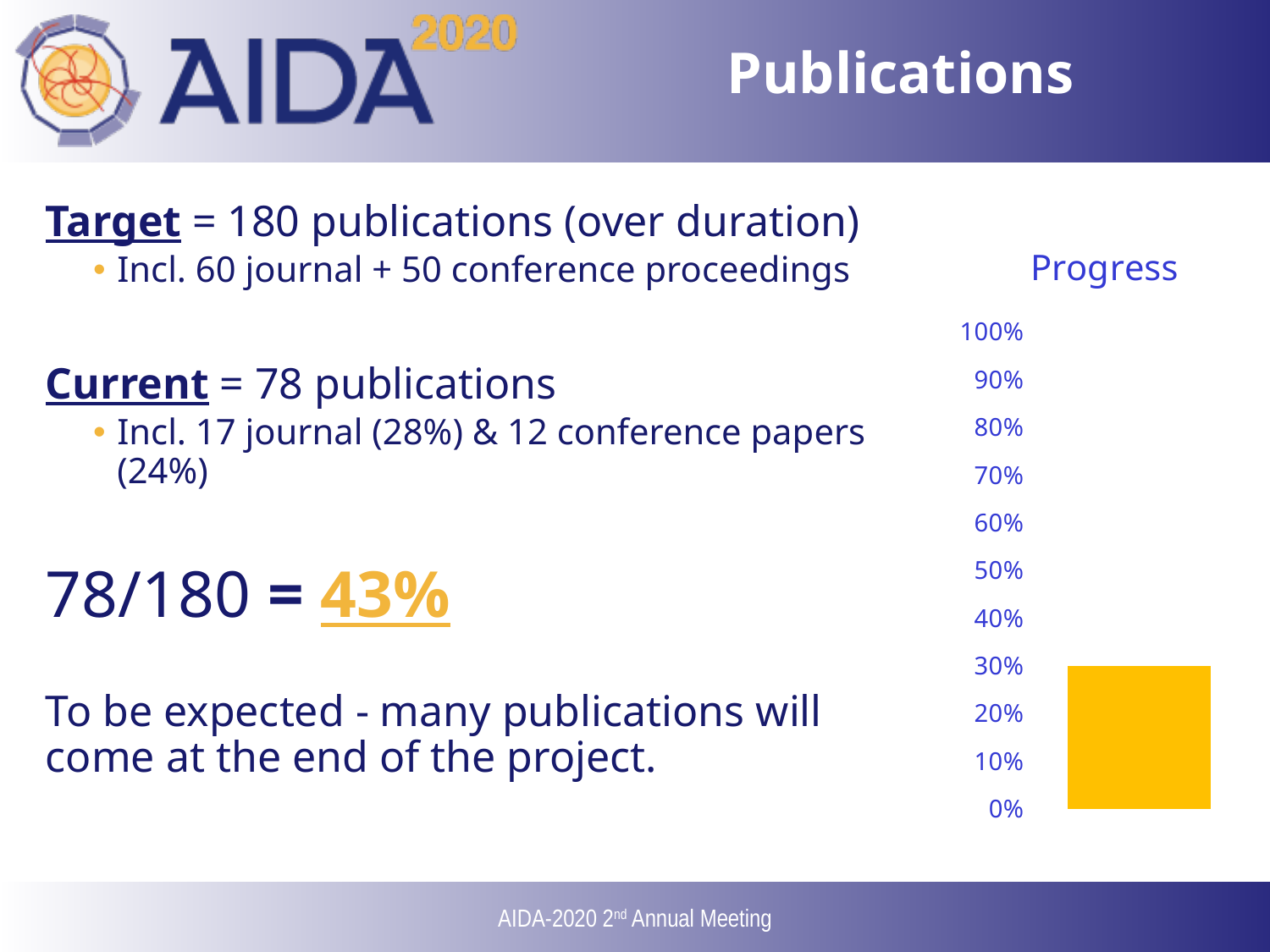
What is the lowest value shown on the vertical axis of the Progress chart? 0% What is the title of the chart on the slide? Progress In the Progress chart, is the value of the bar greater or less than 10%? greater What kind of chart is shown on the right of the slide? bar chart In the Progress chart, is the value of the bar greater or less than 80%? less In the Progress chart, is the value of the bar greater or less than 20%? greater What is the highest value shown on the vertical axis of the Progress chart? 100% How many bars are plotted in the Progress chart? 1